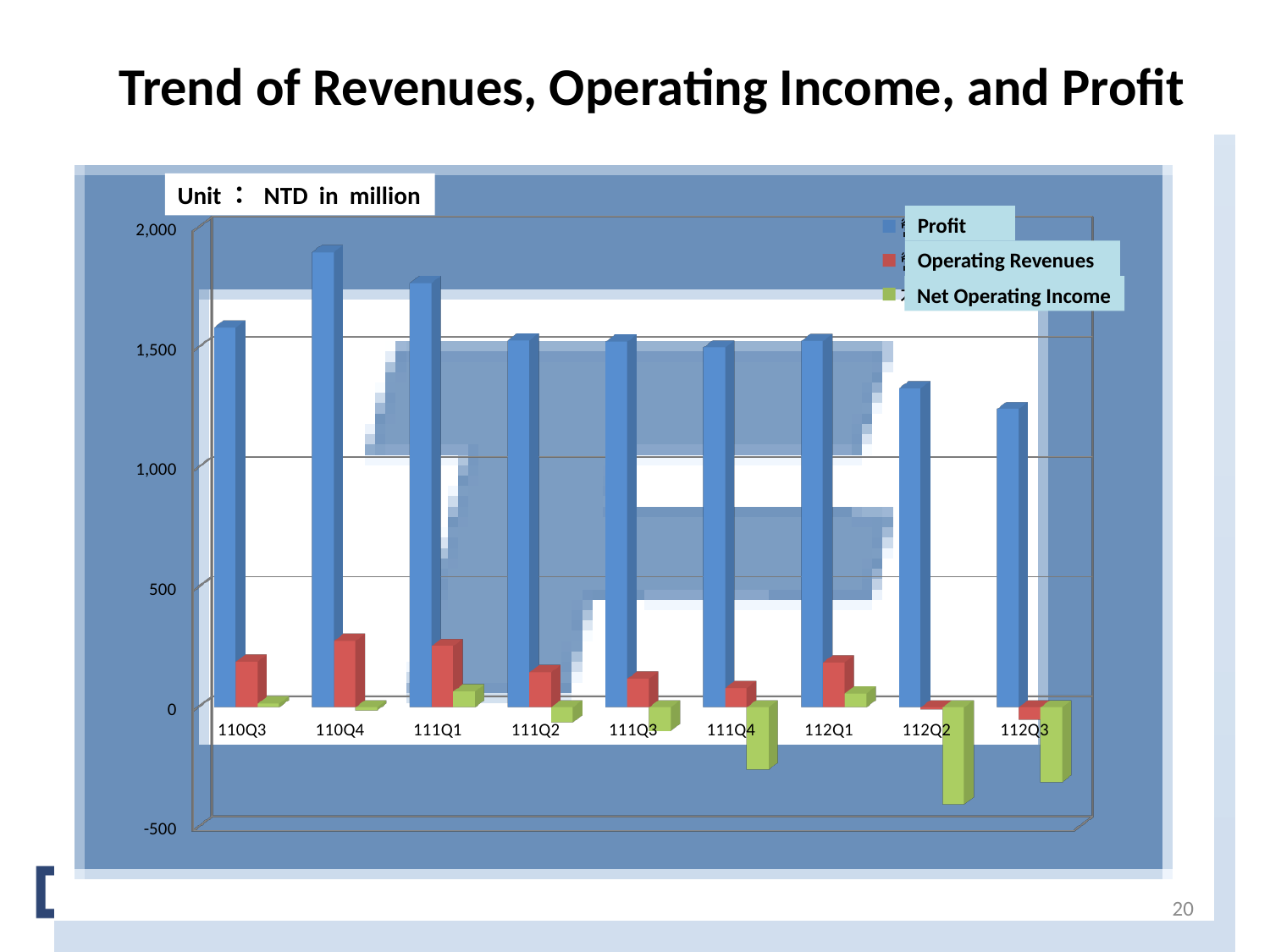
In which quarter is the Profit (blue) bar highest? 110Q4 What kind of chart is shown on the slide? bar chart How many quarters are shown on the x axis? 9 How many series does the legend list? 3 In which quarter is the Profit (blue) bar lowest? 112Q3 Which series is shown in green in the legend? Net Operating Income What unit is stated for the values in the chart? NTD in million Which quarter has the larger Profit bar, 110Q3 or 111Q1? 111Q1 Is the Profit value for 110Q4 greater or less than 1,500? greater In which quarter is the Net Operating Income (green) bar lowest? 112Q2 Is the Profit value for 112Q3 greater or less than 1,500? less Is the Net Operating Income value for 112Q2 greater or less than 0? less